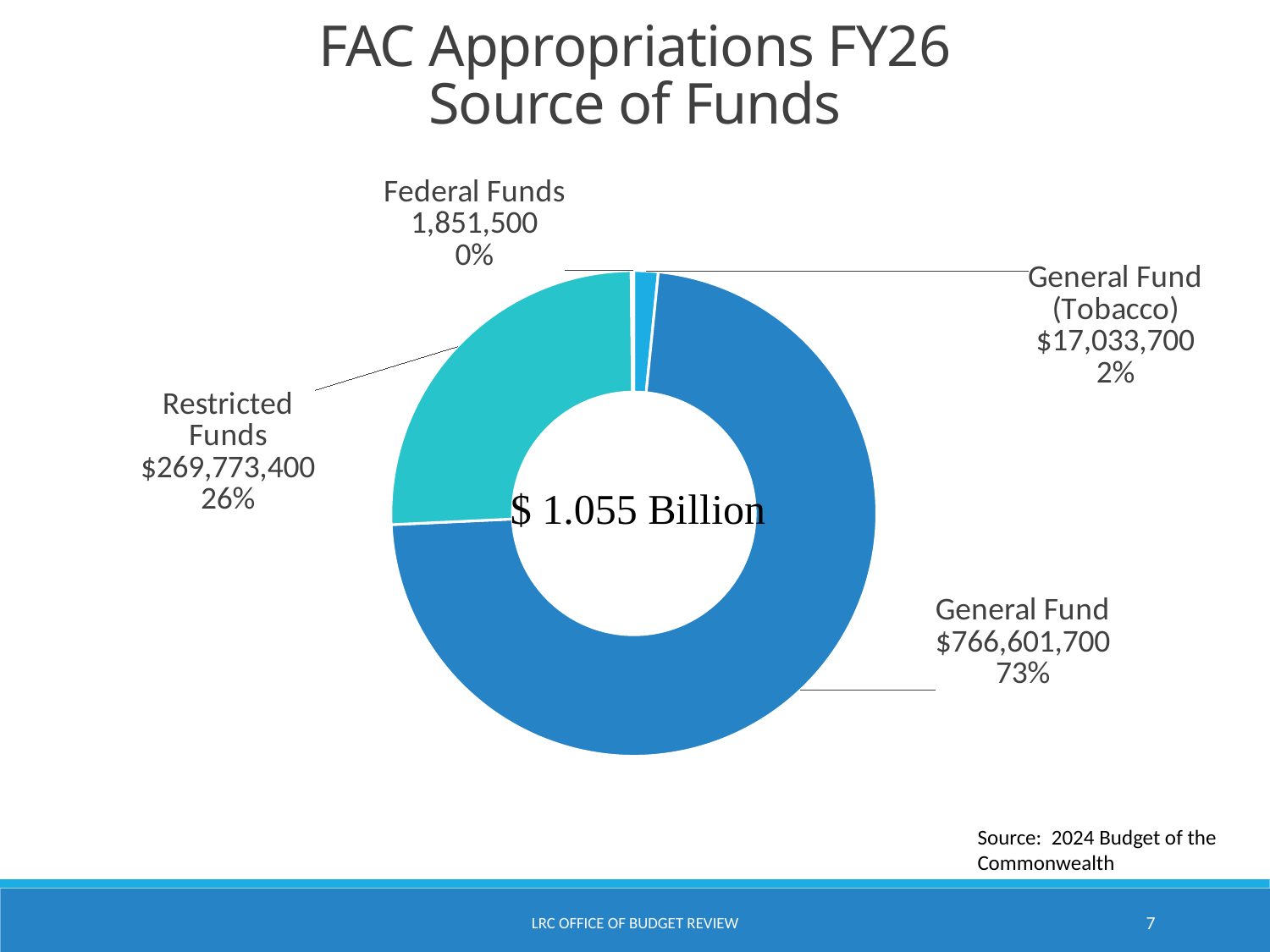
What is the value shown for Restricted Funds? $269,773,400 What percentage share does Restricted Funds have? 26% What percentage share does General Fund (Tobacco) have? 2% What is the value shown for General Fund? $766,601,700 What is the difference between the General Fund value and the Restricted Funds value? $496,828,300 What is the value shown for Federal Funds? 1,851,500 What kind of chart is shown on the slide? doughnut chart Which is larger, Restricted Funds or General Fund (Tobacco)? Restricted Funds Which source of funds has the largest share? General Fund How many sources of funds are shown in the chart? 4 What is the value shown for General Fund (Tobacco)? $17,033,700 Which source of funds has the smallest share? Federal Funds